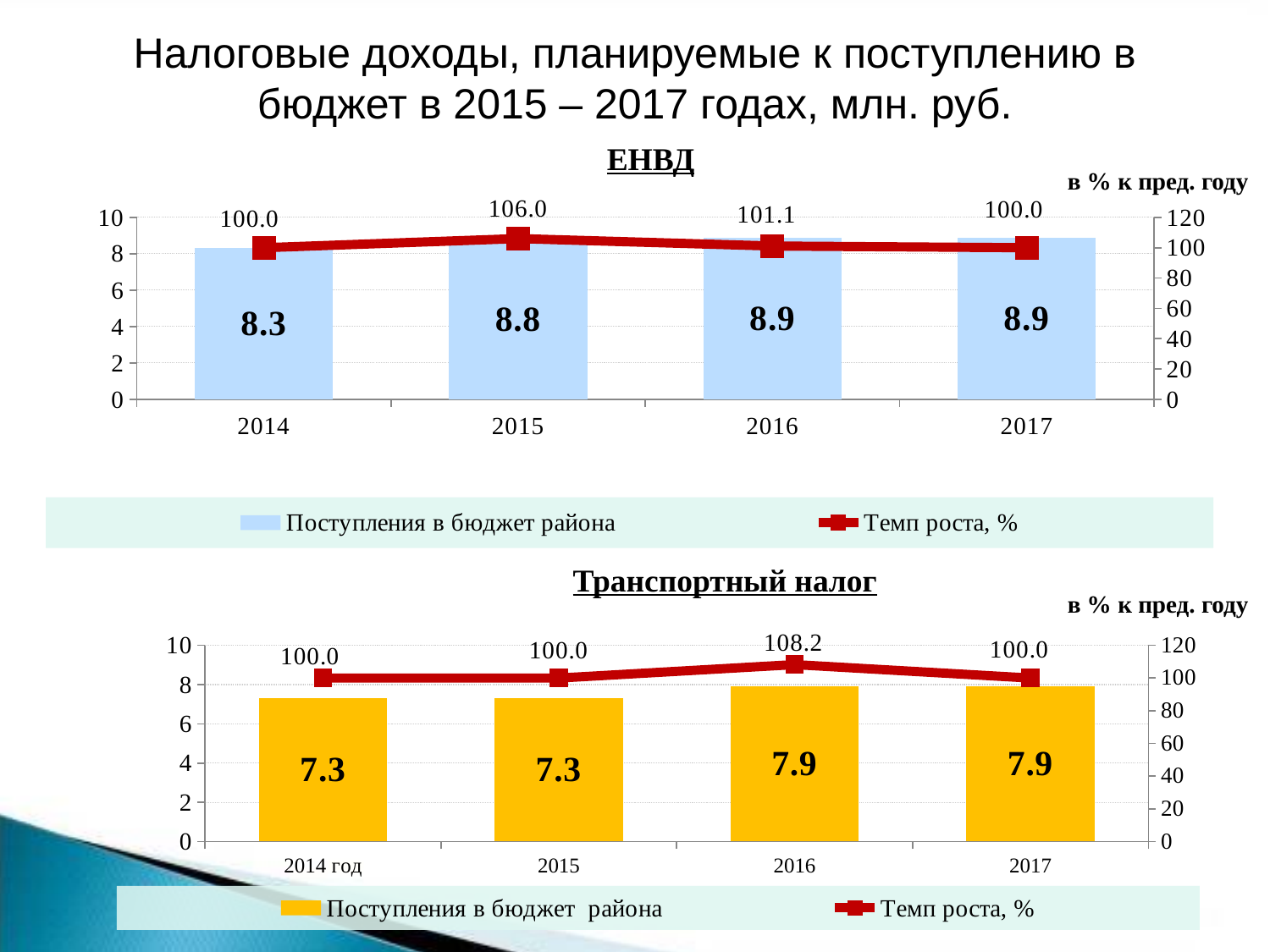
In the ЕНВД chart, what is the Темп роста, % value for 2016? 101.1 In the Транспортный налог chart, what is the difference between the Поступления в бюджет района values for 2016 and 2015? 0.6 In the ЕНВД chart, which year has the highest Темп роста, % value? 2015 In the ЕНВД chart, which year has the lowest value of Поступления в бюджет района? 2014 In the Транспортный налог chart, which year has the highest Темп роста, % value? 2016 In the ЕНВД chart, what is the value of Поступления в бюджет района for 2015? 8.8 In the Транспортный налог chart, is the Поступления в бюджет района value for 2015 larger or smaller than the value for 2016? smaller How many series does the legend of the Транспортный налог chart list? 2 In the Транспортный налог chart, what is the value of Поступления в бюджет района for 2017? 7.9 In the ЕНВД chart, what is the difference between the Поступления в бюджет района values for 2016 and 2014? 0.6 In the Транспортный налог chart, what is the Темп роста, % value for 2016? 108.2 How many years are shown on the x axis of the ЕНВД chart? 4